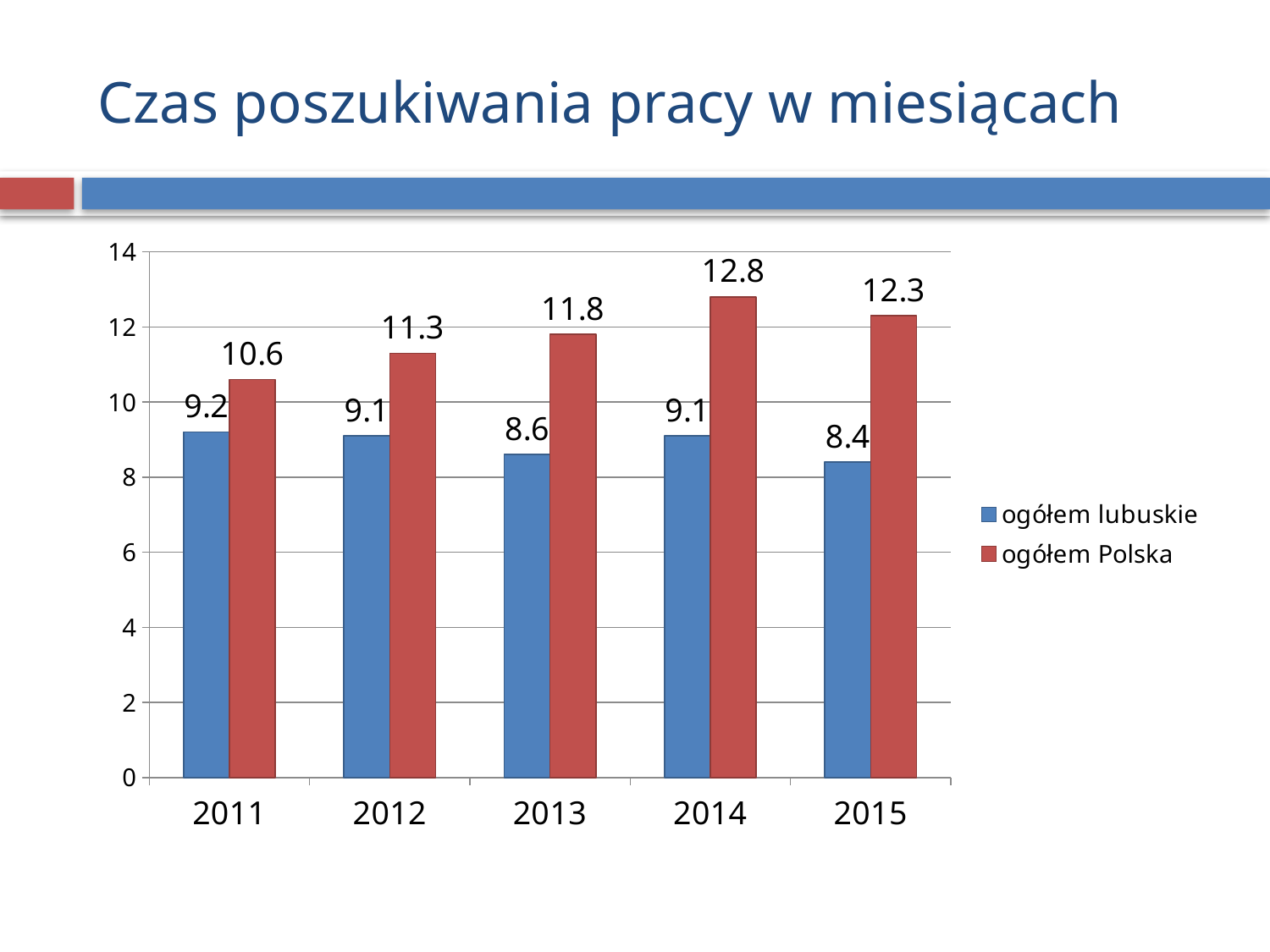
What is the value for ogółem lubuskie in 2011? 9.2 What kind of chart is shown on the slide? bar chart Is the value for ogółem Polska in 2013 greater or less than 10? greater In which year is the value for ogółem Polska highest? 2014 What is the value for ogółem Polska in 2014? 12.8 What is the title of the slide? Czas poszukiwania pracy w miesiącach Which is larger in 2012, ogółem lubuskie or ogółem Polska? ogółem Polska What is the value for ogółem lubuskie in 2013? 8.6 How many years are shown on the x axis? 5 In which year is the value for ogółem lubuskie lowest? 2015 How many series does the legend list? 2 What is the difference between ogółem Polska and ogółem lubuskie in 2015? 3.9